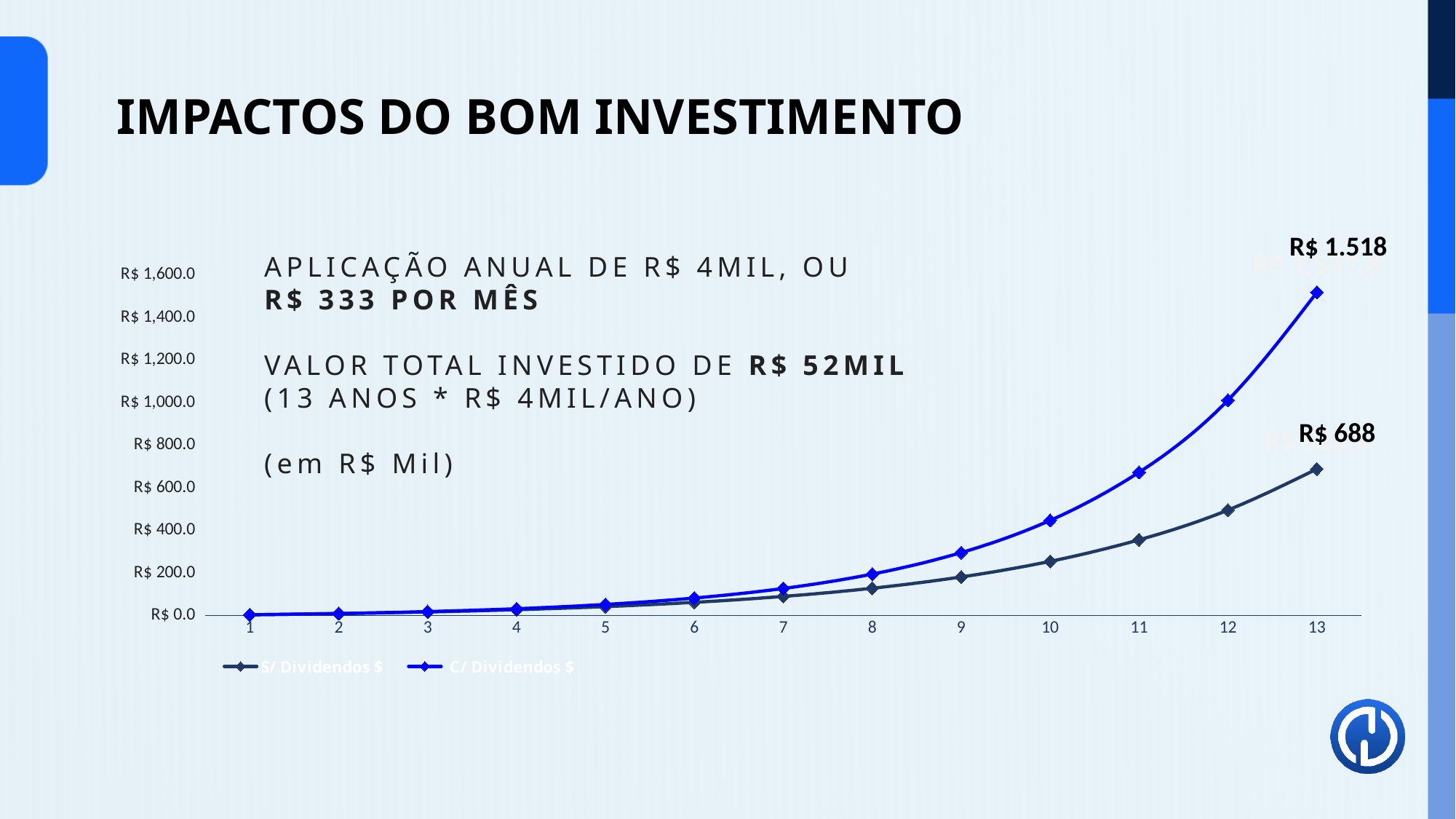
Is the value of the S/ Dividendos $ series at point 12 greater or less than R$ 400.0? greater What is the value of the S/ Dividendos $ series at point 13? R$ 688 Which series reaches the highest value on the chart? C/ Dividendos $ At point 13, which series has the larger value, S/ Dividendos $ or C/ Dividendos $? C/ Dividendos $ What kind of chart is shown on the slide? line chart What are the two entries listed in the chart legend? S/ Dividendos $ and C/ Dividendos $ How many points (years) are plotted along the x axis? 13 What is the value of the C/ Dividendos $ series at point 13? R$ 1.518 Is the value of the C/ Dividendos $ series at point 11 greater or less than R$ 800.0? less Do the values of the C/ Dividendos $ series rise or fall from point 1 to point 13? rise What is the difference between the C/ Dividendos $ and S/ Dividendos $ values at point 13? R$ 830 How many series does the chart legend list? 2